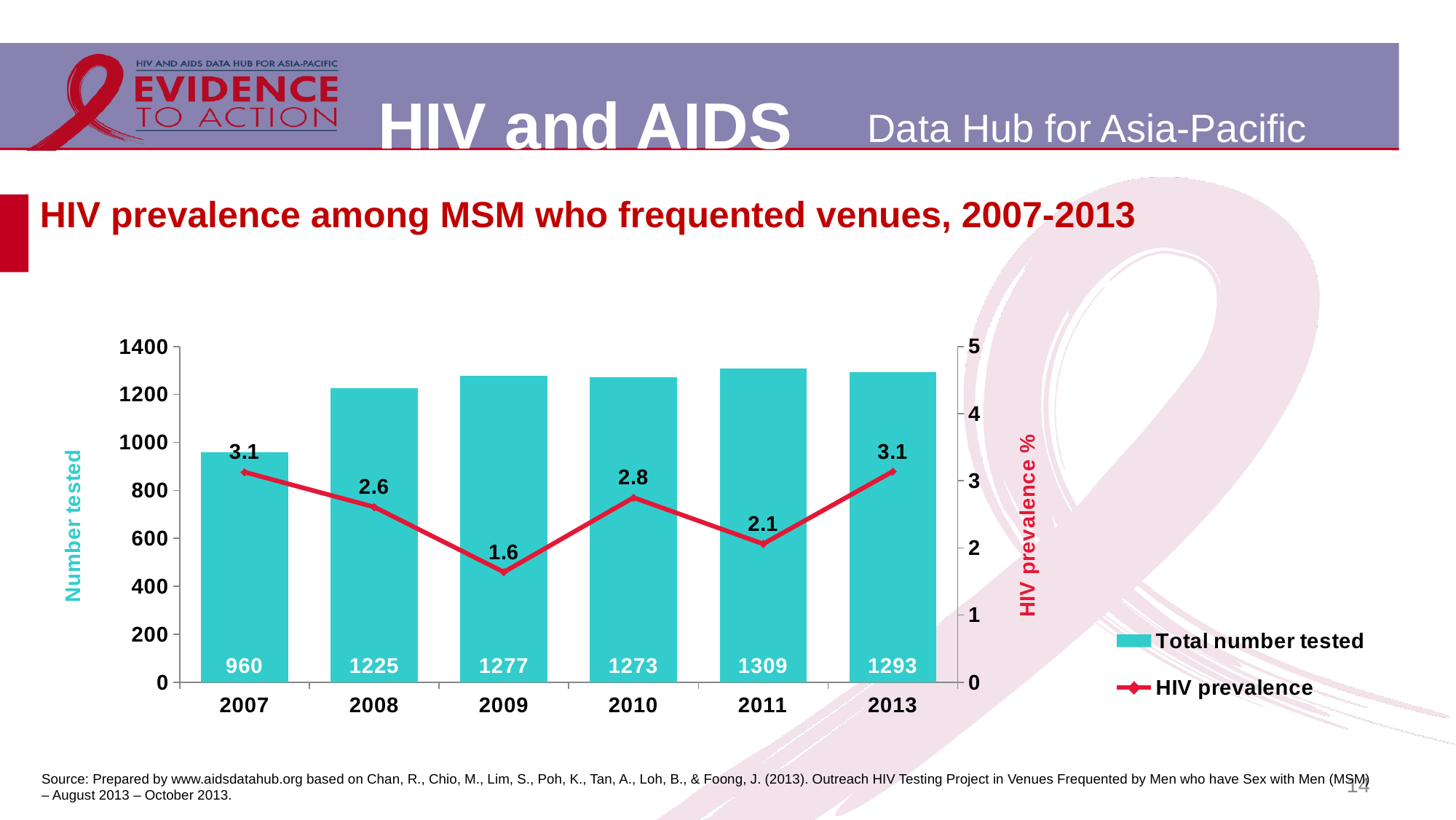
What is the label of the right-hand vertical axis? HIV prevalence % Which year had the lowest HIV prevalence? 2009 What is the difference in total number tested between 2011 and 2007? 349 Did the HIV prevalence rise or fall from 2011 to 2013? rise How many series does the legend list? 2 Which year had the lowest total number tested? 2007 What was the total number tested in 2009? 1277 Which year had the highest total number tested? 2011 What was the HIV prevalence in 2011? 2.1 What is the difference in HIV prevalence between 2010 and 2009? 1.2 How many years are shown on the x axis? 6 Was the HIV prevalence higher in 2008 or in 2010? 2010